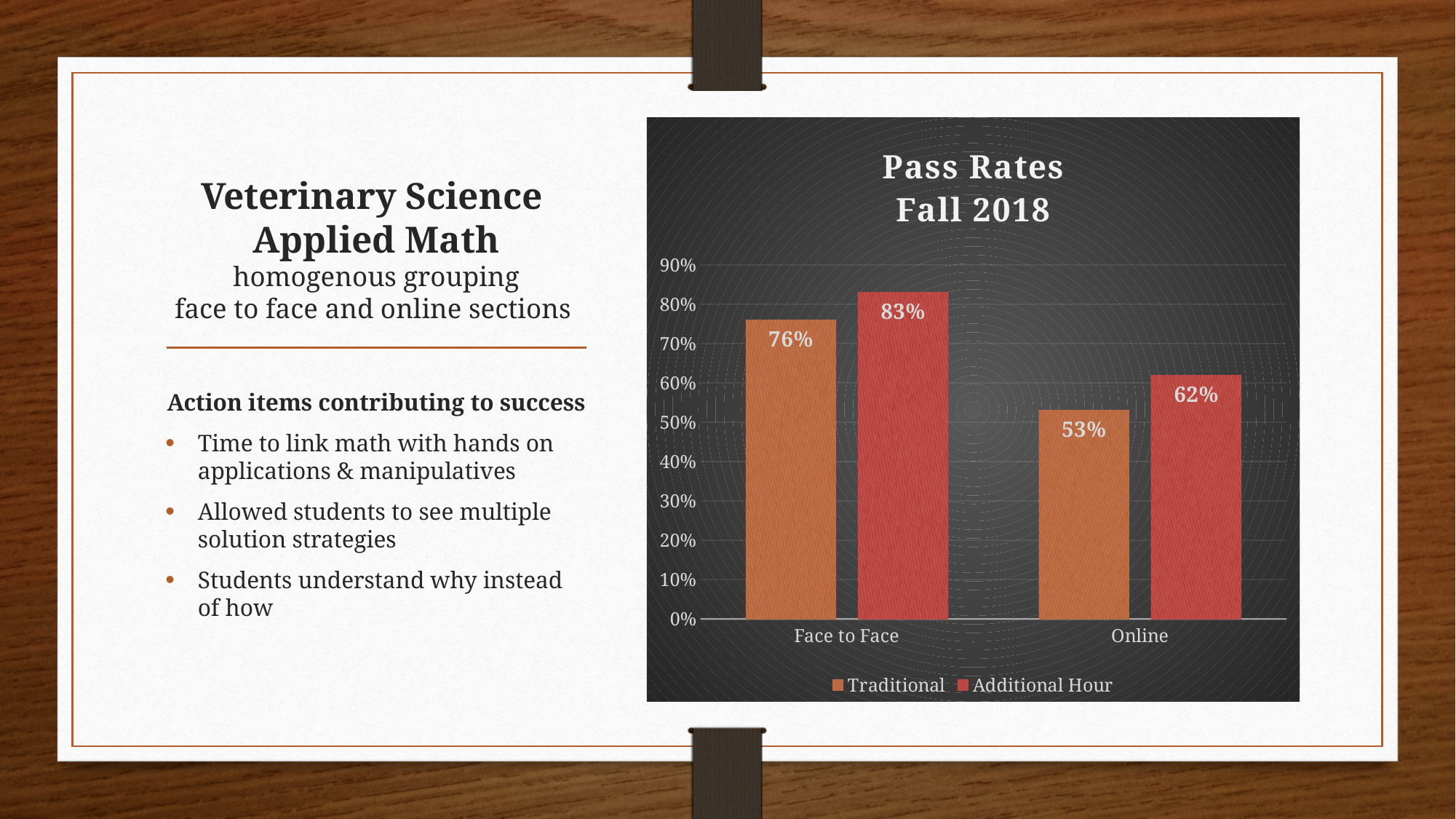
How many series does the legend list? 2 What is the Traditional pass rate for Online? 53% What is the difference between the Additional Hour and Traditional pass rates for Face to Face? 7% Which bar has the highest pass rate? Additional Hour, Face to Face What is the Additional Hour pass rate for Online? 62% What is the title of the chart? Pass Rates Fall 2018 What is the difference between the Additional Hour and Traditional pass rates for Online? 9% Which bar has the lowest pass rate? Traditional, Online What kind of chart is shown? Bar chart Which is larger: the Traditional pass rate for Face to Face or the Additional Hour pass rate for Online? Traditional pass rate for Face to Face What is the Traditional pass rate for Face to Face? 76% What is the Additional Hour pass rate for Face to Face? 83%